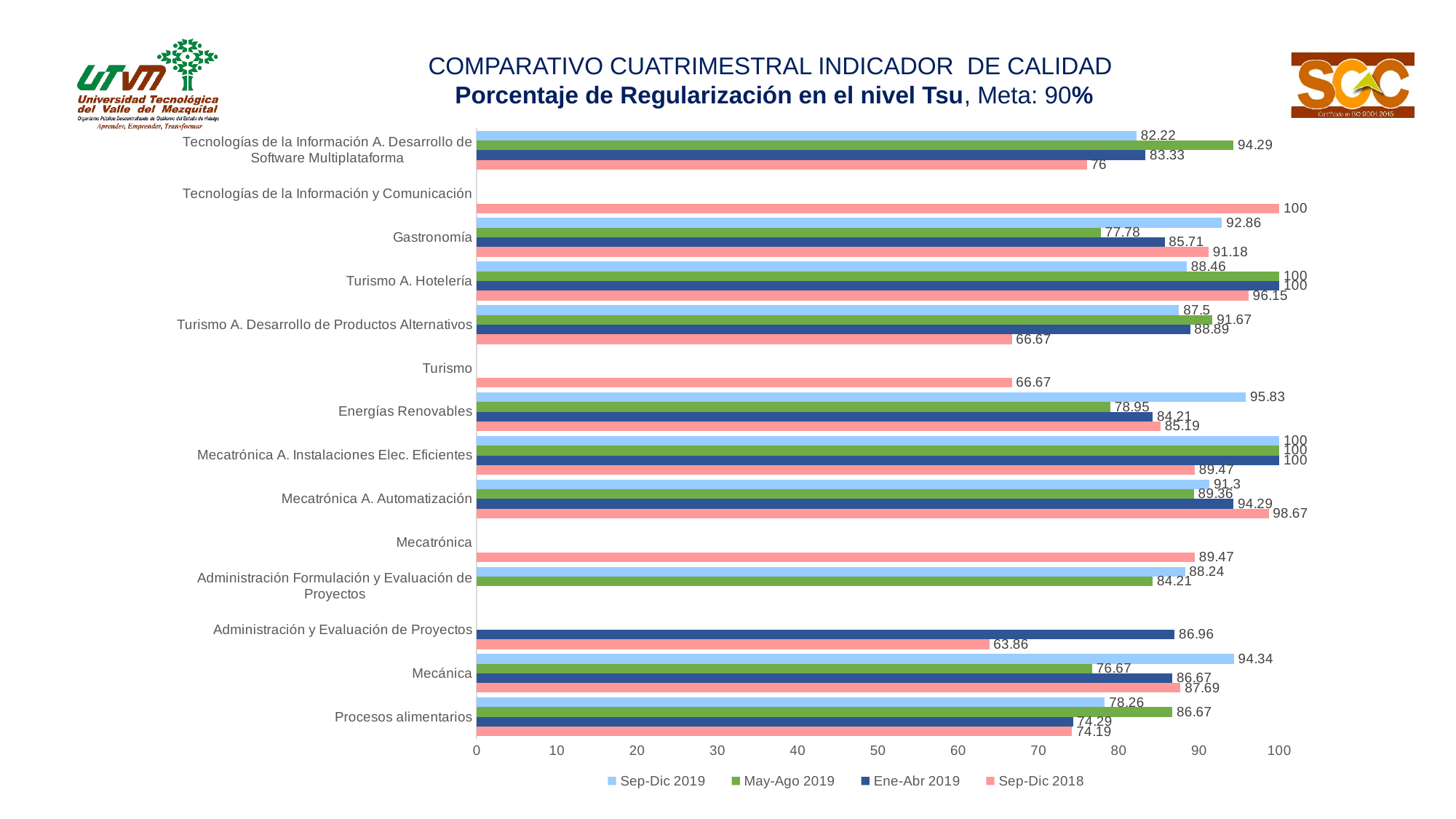
How many series does the legend list? 4 For Procesos alimentarios, which is larger: the May-Ago 2019 value or the Sep-Dic 2019 value? May-Ago 2019 What is the May-Ago 2019 value for Gastronomía? 77.78 How many categories are listed on the vertical axis of the chart? 14 Which category has the highest Sep-Dic 2019 value? Mecatrónica A. Instalaciones Elec. Eficientes Is the Sep-Dic 2018 value for Turismo A. Desarrollo de Productos Alternativos greater or less than 70? less What kind of chart is shown on the slide? bar chart What target (Meta) is stated in the chart title? 90% What is the Sep-Dic 2018 value for Administración y Evaluación de Proyectos? 63.86 What is the Sep-Dic 2019 value for Energías Renovables? 95.83 What is the difference between the Sep-Dic 2019 and Sep-Dic 2018 values for Mecánica? 6.65 Which category has the lowest Sep-Dic 2018 value? Administración y Evaluación de Proyectos